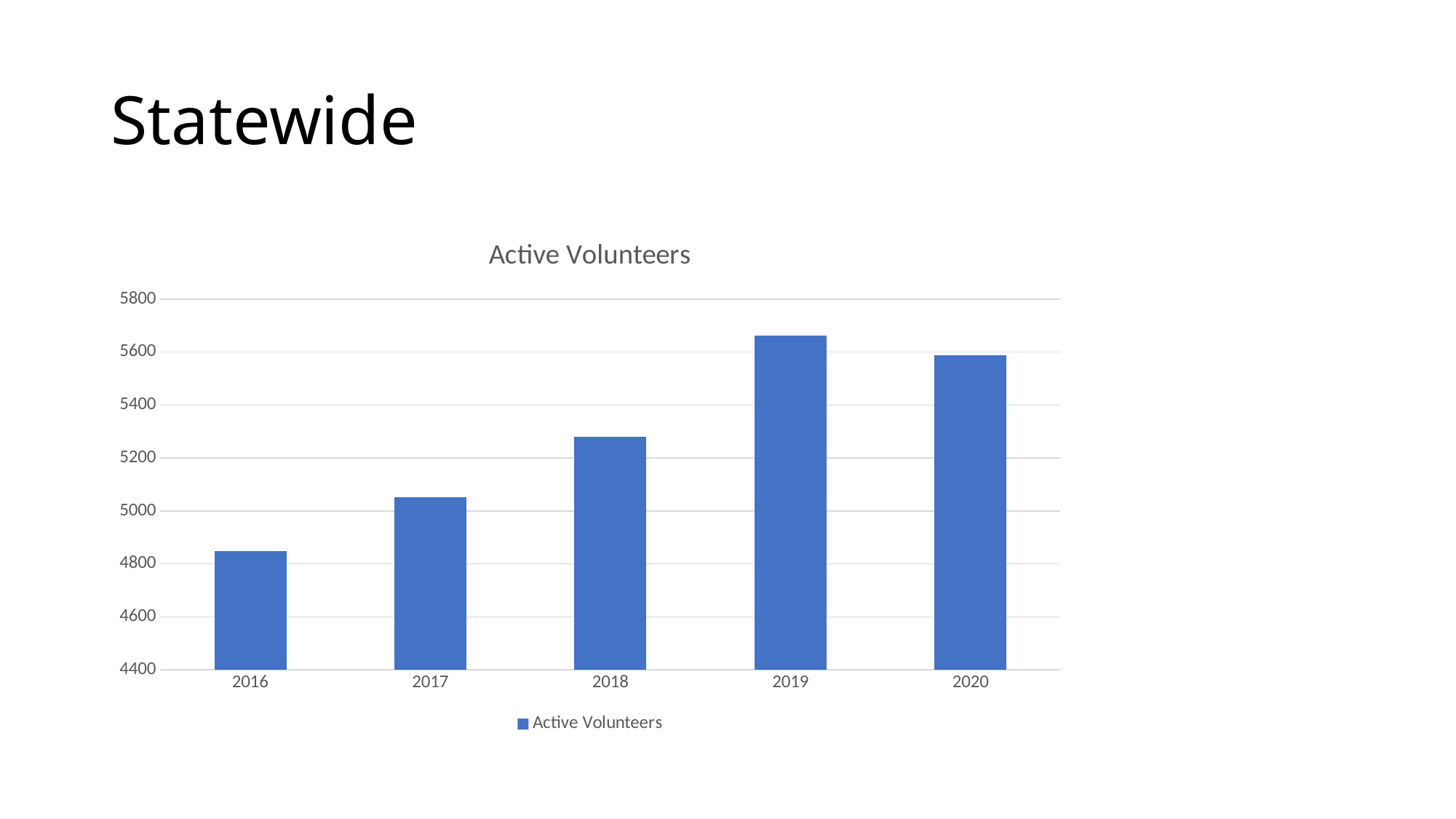
Which year has the highest number of active volunteers? 2019 Which year has the lowest number of active volunteers? 2016 Do the values rise or fall from 2016 to 2019? rise Is the value for 2019 greater or less than 5600? greater What type of chart is shown on the slide? bar chart Is the value for 2020 greater or less than 5400? greater Is the value for 2016 greater or less than 5000? less How many years are shown on the x axis of the chart? 5 What is the title of the chart? Active Volunteers How many series does the legend list? 1 Which year has more active volunteers, 2019 or 2020? 2019